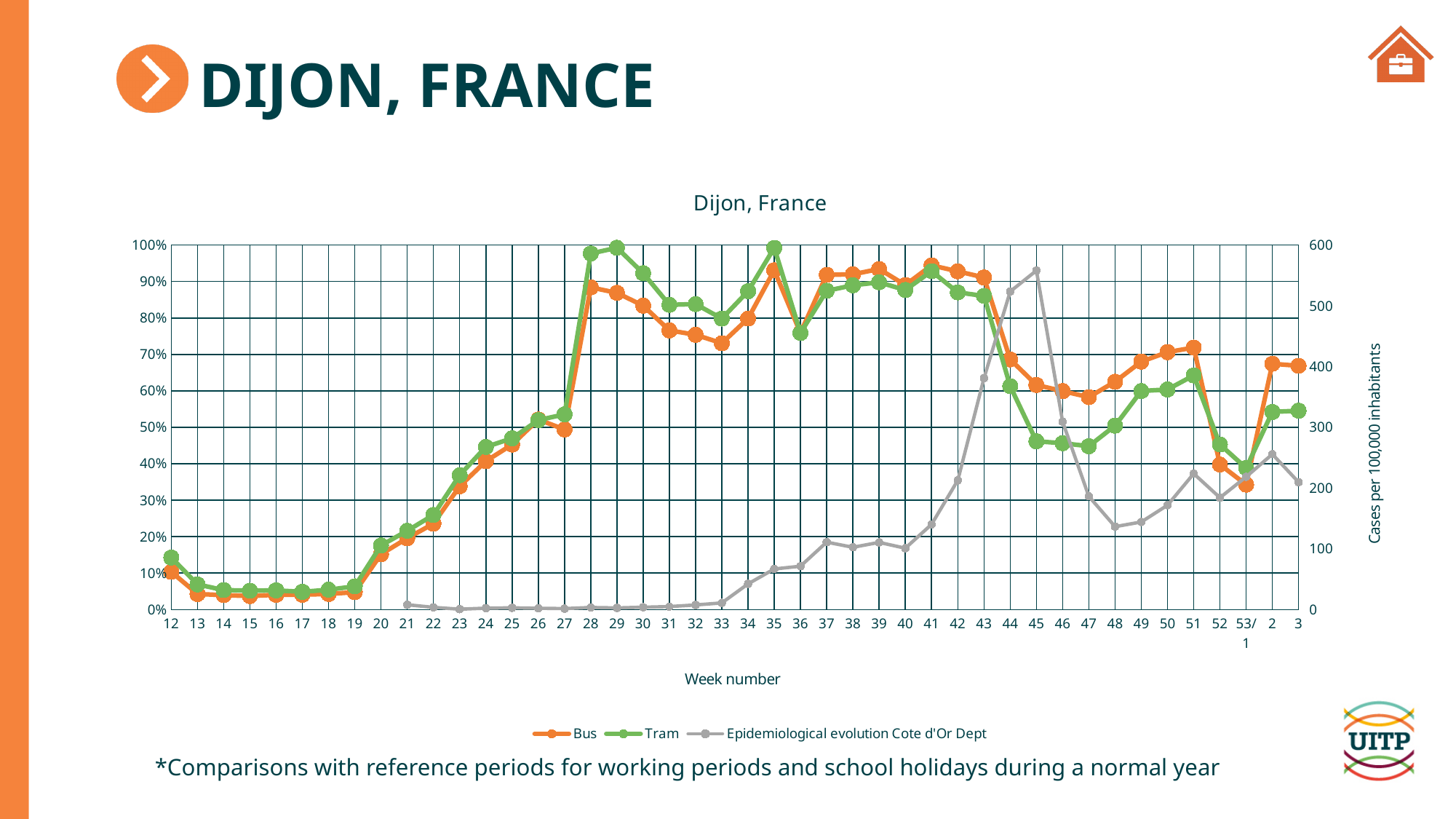
Is the Epidemiological evolution Cote d'Or Dept value for week 48 greater or less than 200? less Is the Bus value for week 28 greater or less than 80%? greater In which week does the Epidemiological evolution Cote d'Or Dept series reach its highest value? 45 Does the Bus series rise or fall between week 19 and week 28? rise Is the Tram value for week 45 greater or less than 50%? less What is the label of the right-hand vertical axis? Cases per 100,000 inhabitants How many series does the legend list? 3 In week 29, which series is higher, Bus or Tram? Tram What kind of chart is shown on the slide? line chart In week 45, which series is higher, Bus or Tram? Bus What are the three series named in the legend? Bus, Tram, Epidemiological evolution Cote d'Or Dept